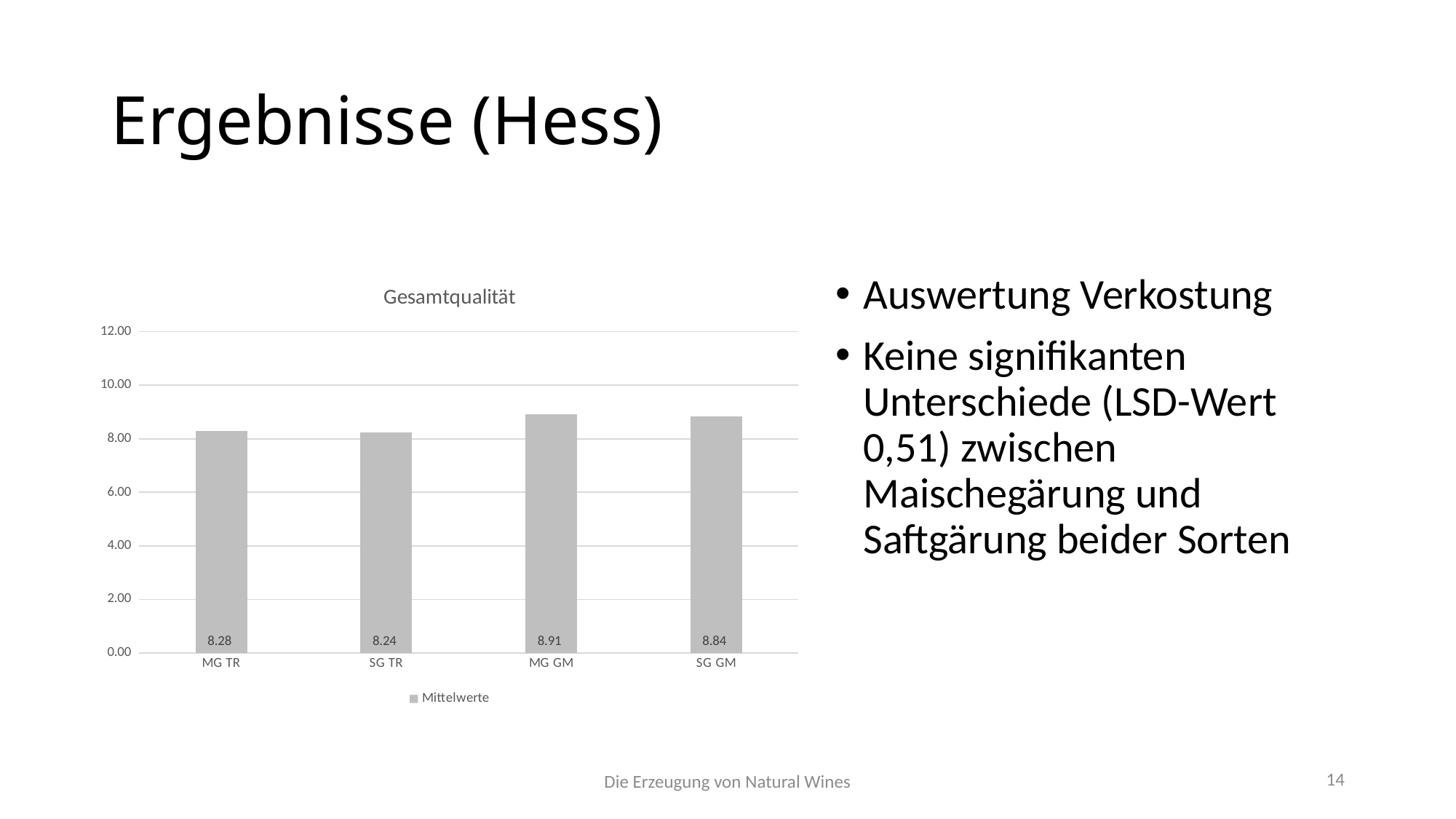
What is the difference between the values for MG GM and SG TR? 0.67 What kind of chart is shown? bar chart What is the value for MG TR? 8.28 Which category has the lowest value? SG TR What is the value for SG GM? 8.84 How many categories are shown on the x axis? 4 How many series does the legend list? 1 Which is larger, the value for MG TR or the value for SG GM? SG GM What is the value for MG GM? 8.91 What is the title of the chart? Gesamtqualität Is the value for SG TR greater or less than 10.00? less Which category has the highest value? MG GM